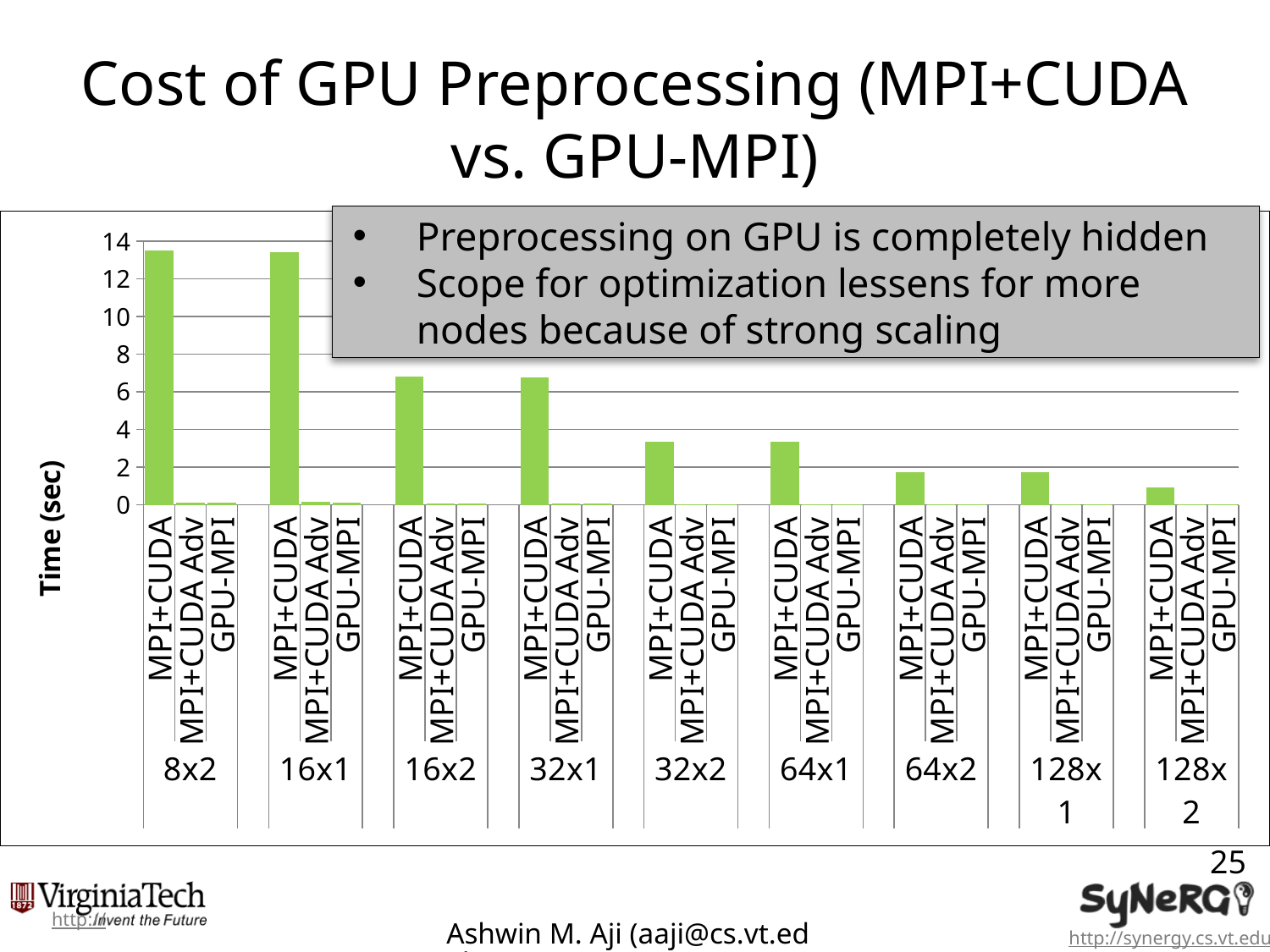
What kind of chart is shown on the slide? bar chart How many bars are plotted in each node configuration group? 3 Is the MPI+CUDA value for the 16x2 configuration greater or less than 8? less Which is larger: the MPI+CUDA value for 8x2 or the MPI+CUDA value for 16x2? 8x2 Within the 64x1 group, which of the three approaches has the highest time? MPI+CUDA Is the MPI+CUDA value for the 8x2 configuration greater or less than 12? greater Among the MPI+CUDA bars, which configuration has the lowest time? 128x2 Do the MPI+CUDA times rise or fall as the configurations move from 8x2 to 128x2 along the x axis? fall Is the MPI+CUDA value for the 32x2 configuration greater or less than 2? greater What is the label of the y axis? Time (sec) How many node configuration groups (such as 8x2, 16x1) are shown along the x axis? 9